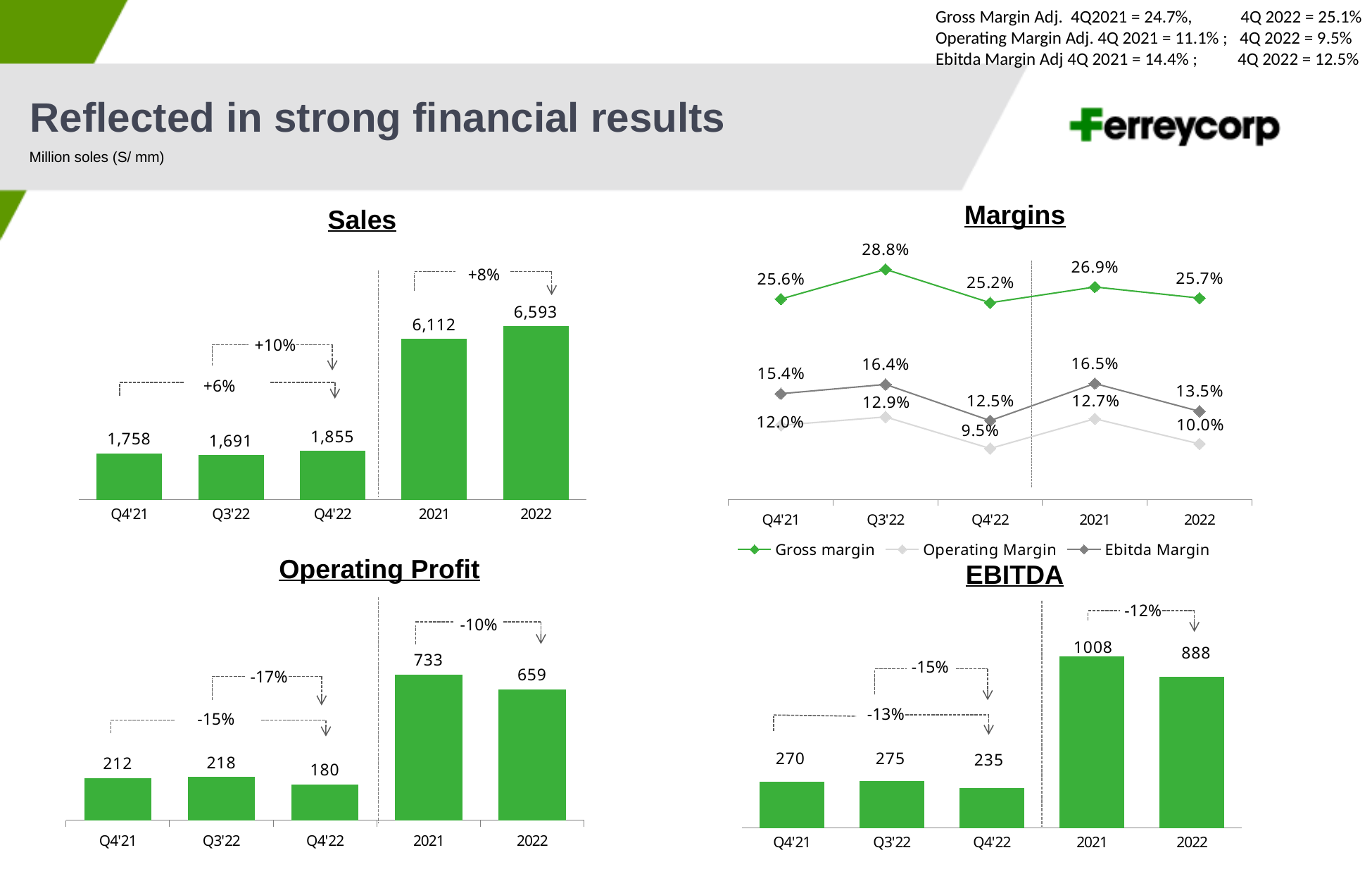
In the EBITDA chart, what is the value for 2021? 1008 In the Margins chart, what is the Operating Margin for Q4'22? 9.5% In the Sales chart, which category has the lowest value? Q3'22 In the Operating Profit chart, what is the value for Q4'22? 180 In the Sales chart, what is the value for 2022? 6,593 In the Operating Profit chart, which is larger, the value for 2021 or 2022? 2021 In the Operating Profit chart, what is the difference between the 2021 and 2022 values? 74 In the Margins chart, what is the Gross margin for Q3'22? 28.8% In the EBITDA chart, which category has the highest value? 2021 What kind of chart is the Margins chart? Line chart How many series does the legend of the Margins chart list? 3 In the Sales chart, what is the difference between the Q4'22 and Q4'21 values? 97